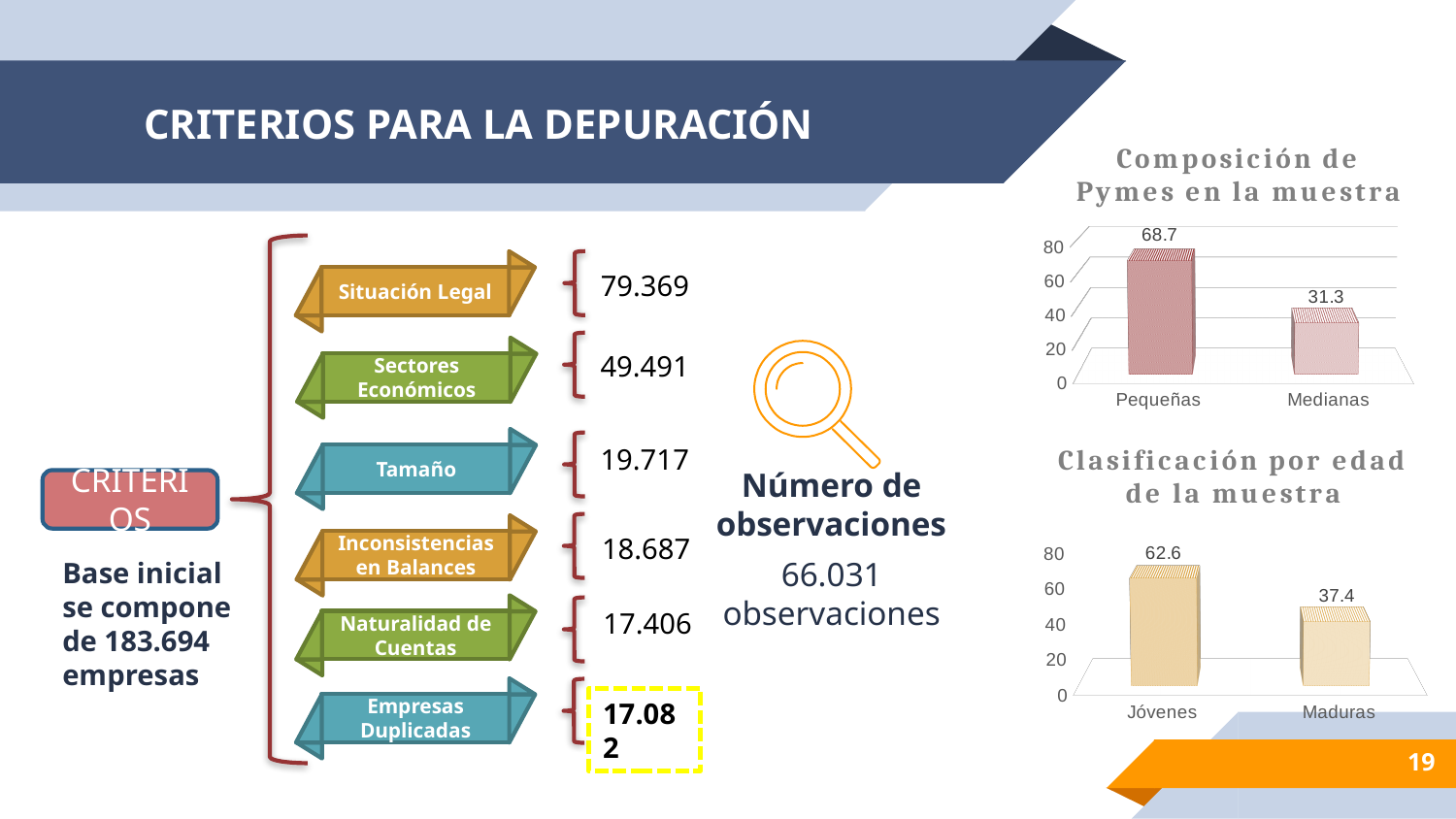
In the 'Composición de Pymes en la muestra' chart, how many categories are shown? 2 In the 'Clasificación por edad de la muestra' chart, what is the value for Maduras? 37.4 What kind of chart is 'Composición de Pymes en la muestra'? Bar chart In the 'Clasificación por edad de la muestra' chart, what is the value for Jóvenes? 62.6 In the 'Clasificación por edad de la muestra' chart, is the value for Maduras greater or less than 40? less In the 'Composición de Pymes en la muestra' chart, which category has the highest value? Pequeñas In the 'Composición de Pymes en la muestra' chart, what is the value for Pequeñas? 68.7 In the 'Composición de Pymes en la muestra' chart, what is the value for Medianas? 31.3 In the 'Clasificación por edad de la muestra' chart, what is the difference between Jóvenes and Maduras? 25.2 In the 'Composición de Pymes en la muestra' chart, what is the difference between Pequeñas and Medianas? 37.4 In the 'Clasificación por edad de la muestra' chart, which category has the lowest value? Maduras In the 'Clasificación por edad de la muestra' chart, which is larger, Jóvenes or Maduras? Jóvenes